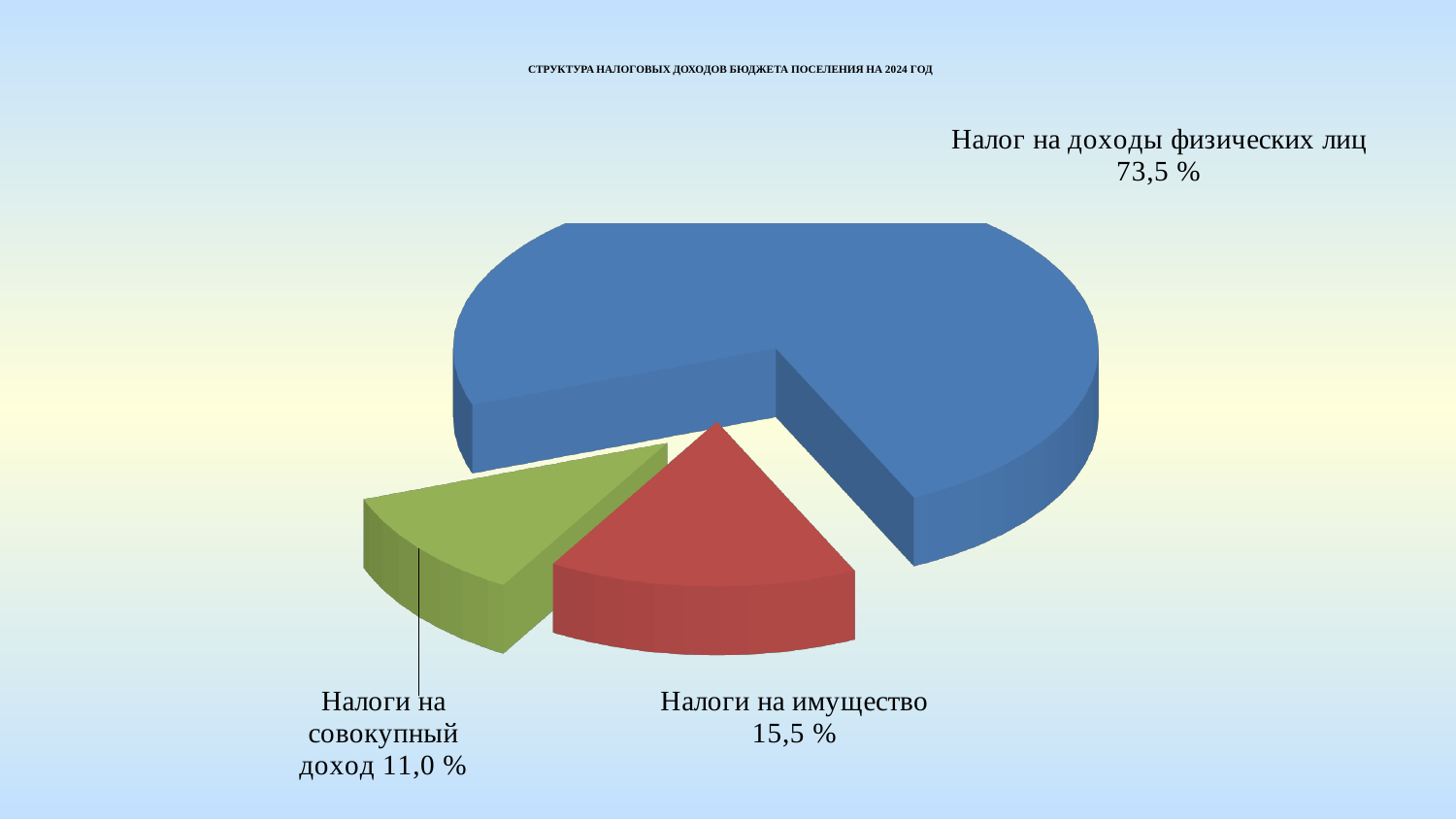
What is the difference in percentage points between Налог на доходы физических лиц and Налоги на имущество? 58,0 Which is larger: Налоги на имущество or Налоги на совокупный доход? Налоги на имущество What colour is the slice for Налоги на имущество? Red What share of the pie does Налог на доходы физических лиц represent? 73,5 % What is the value shown for Налоги на совокупный доход? 11,0 % What is the value shown for Налоги на имущество? 15,5 % What is the title of the chart? СТРУКТУРА НАЛОГОВЫХ ДОХОДОВ БЮДЖЕТА ПОСЕЛЕНИЯ НА 2024 ГОД What is the difference in percentage points between Налоги на имущество and Налоги на совокупный доход? 4,5 Which category has the largest slice of the pie? Налог на доходы физических лиц Which category has the smallest slice of the pie? Налоги на совокупный доход How many slices does the pie chart have? 3 What kind of chart is shown on the slide? Pie chart